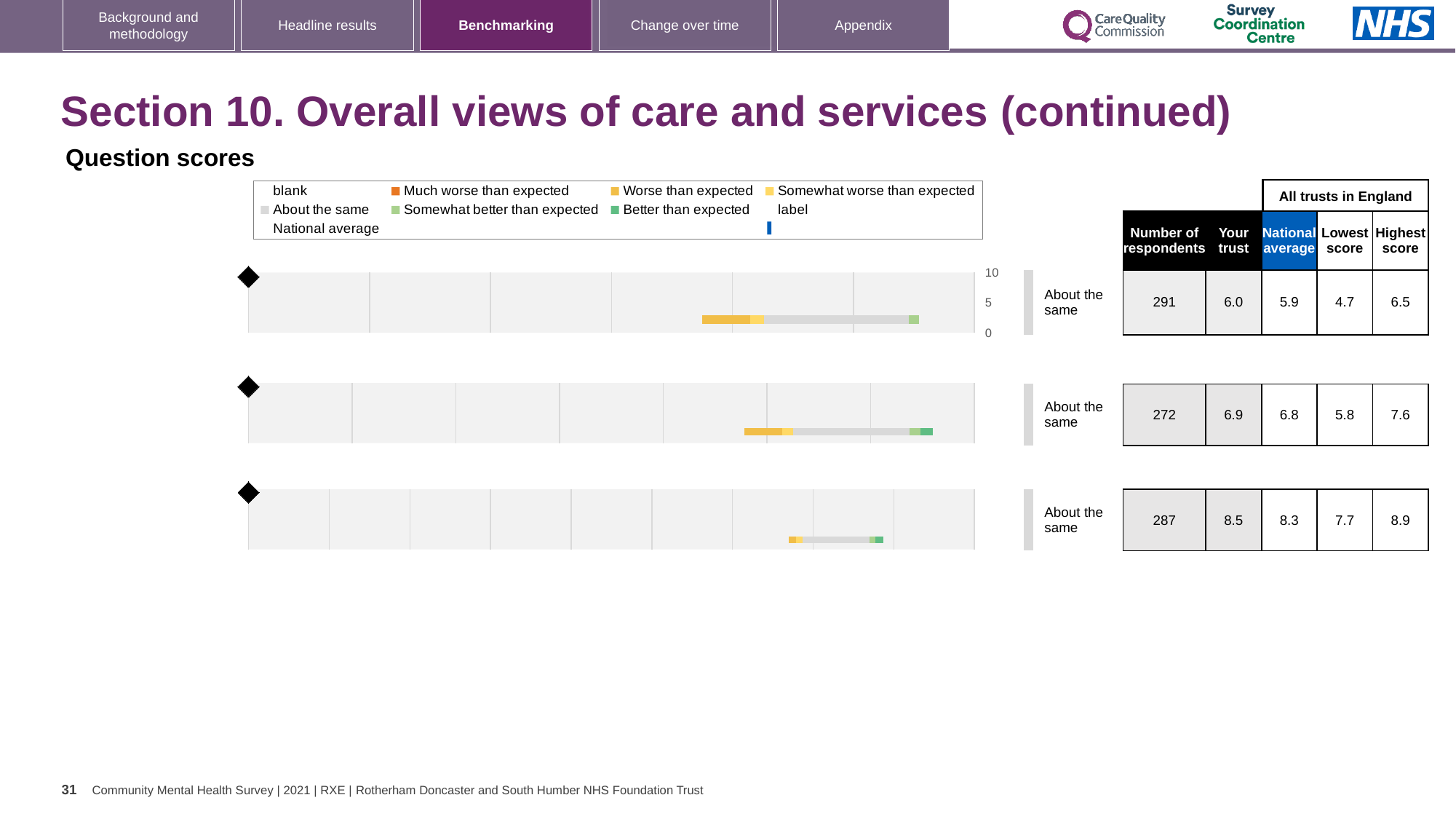
What benchmark category is shown next to each of the three charts? About the same Which chart (top, middle or bottom) has the highest 'Your trust' score? bottom How many charts (question score bars) are shown on the slide? 3 For the top chart, what is the difference between the highest score and the lowest score among all trusts in England? 1.8 For the bottom chart, what is the highest score among all trusts in England? 8.9 What kind of chart is used on this slide to show the question scores? bar chart For the top chart, what is the national average score? 5.9 For the middle chart, which is larger: the 'Your trust' score or the national average? Your trust For the bottom chart, what is the difference between the 'Your trust' score and the national average? 0.2 For the top chart, what is the 'Your trust' score shown in the table? 6.0 For the middle chart, what is the lowest score among all trusts in England? 5.8 For the middle chart, how many respondents are listed? 272